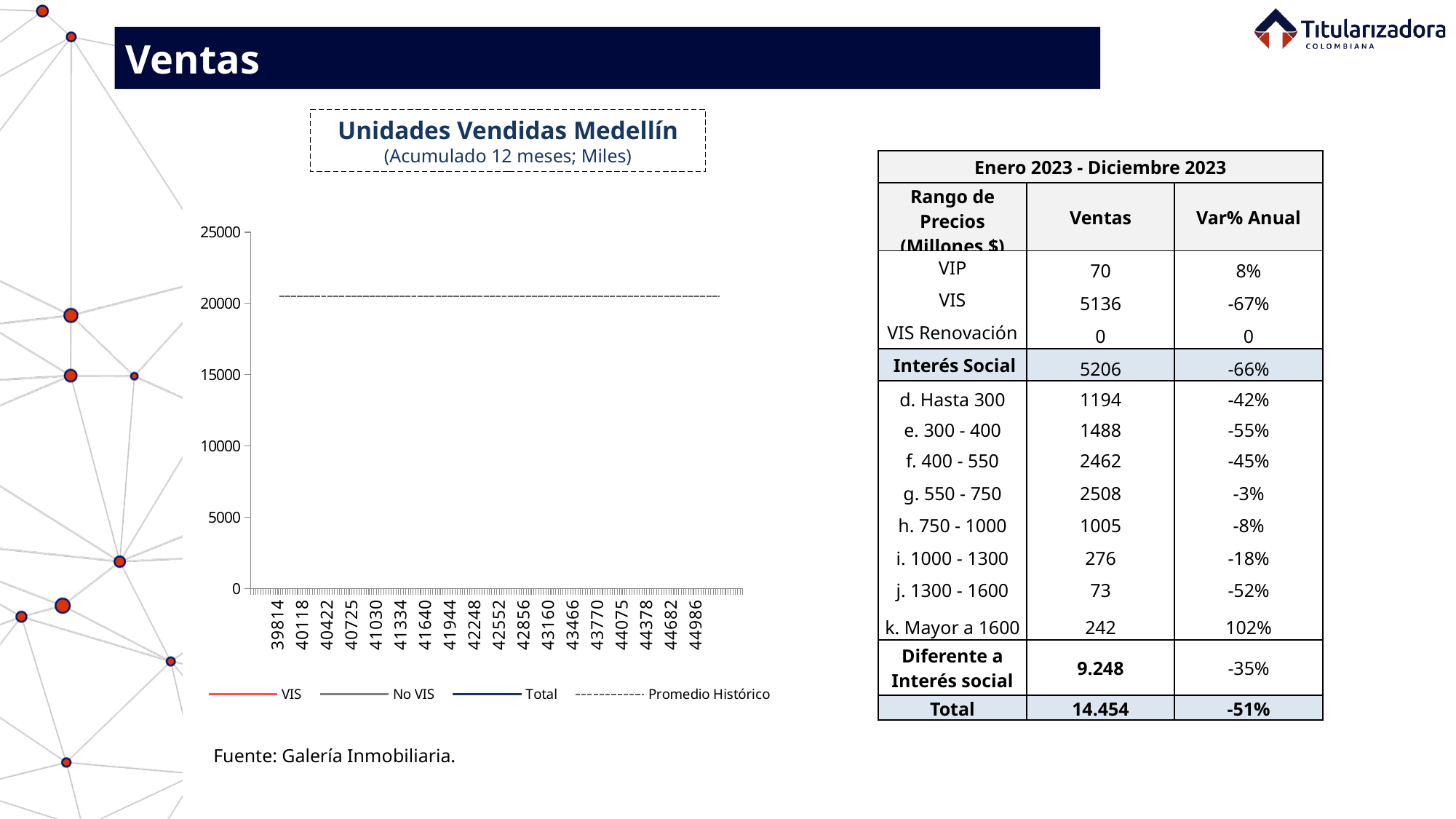
How many series does the legend of the 'Unidades Vendidas Medellín' chart list? 4 In the 'Unidades Vendidas Medellín' chart, is the value of the Promedio Histórico line greater or less than 25000? less What are the legend entries of the 'Unidades Vendidas Medellín' chart? VIS, No VIS, Total, Promedio Histórico Does the Promedio Histórico line in the 'Unidades Vendidas Medellín' chart rise, fall or stay flat along the x axis? stays flat Which series in the 'Unidades Vendidas Medellín' chart is drawn as a dashed line? Promedio Histórico In the 'Unidades Vendidas Medellín' chart, is the Promedio Histórico line greater or less than 15000? greater What kind of chart is shown under the title 'Unidades Vendidas Medellín'? line chart In the 'Unidades Vendidas Medellín' chart, is the value of the Promedio Histórico line greater or less than 20000? greater